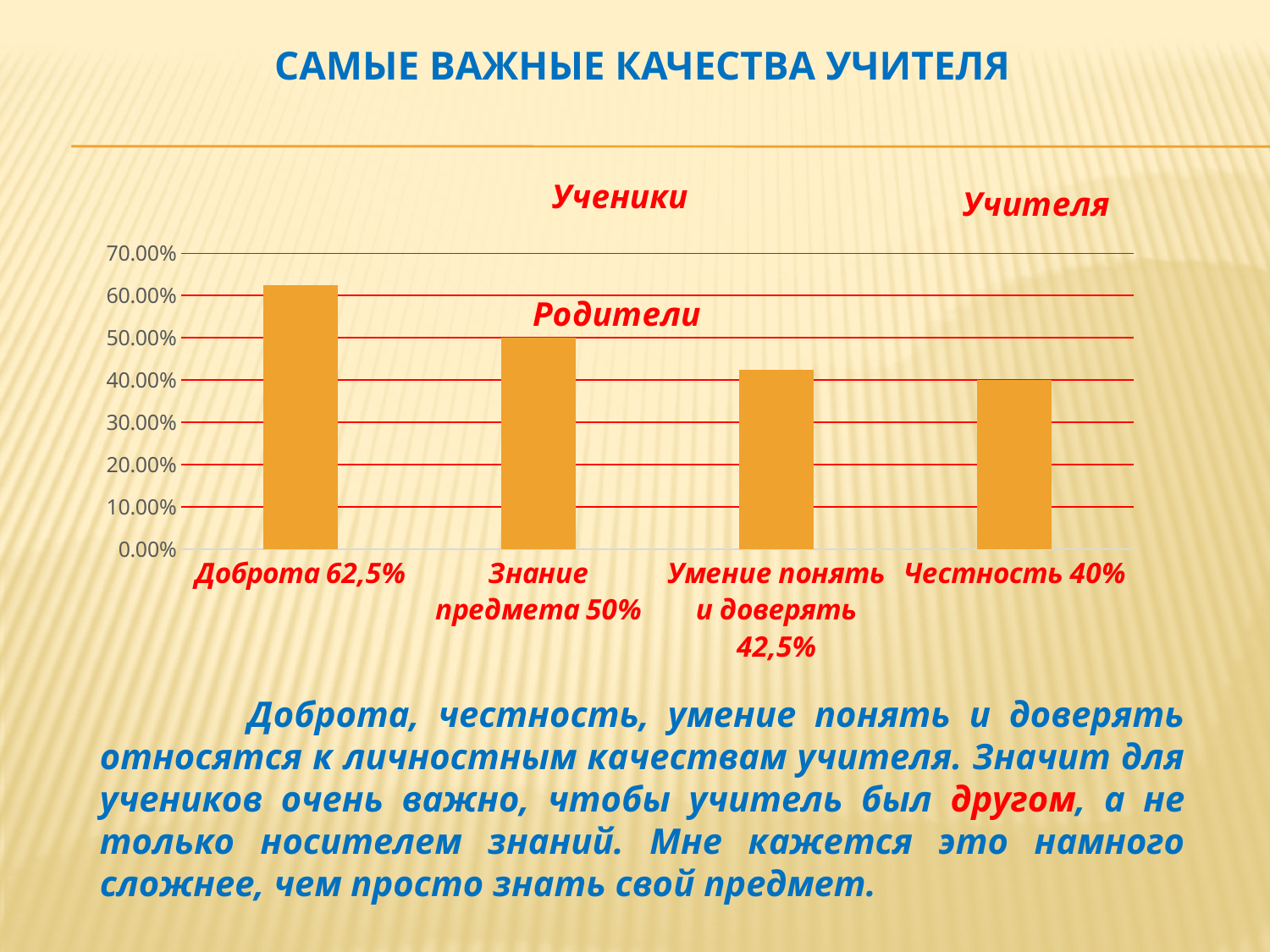
Which category has the lowest value? Честность Which is larger, the value for Знание предмета or the value for Умение понять и доверять? Знание предмета What is the difference between the values for Доброта and Знание предмета? 12,5% What value is shown for Умение понять и доверять? 42,5% What kind of chart is shown on the slide? Bar chart What value is shown for Честность? 40% How many categories are shown in the chart? 4 What value is shown for Знание предмета? 50% What is the difference between the values for Доброта and Честность? 22,5% What value is shown for Доброта? 62,5% Do the values rise or fall from left to right across the categories? Fall Which category has the highest value? Доброта